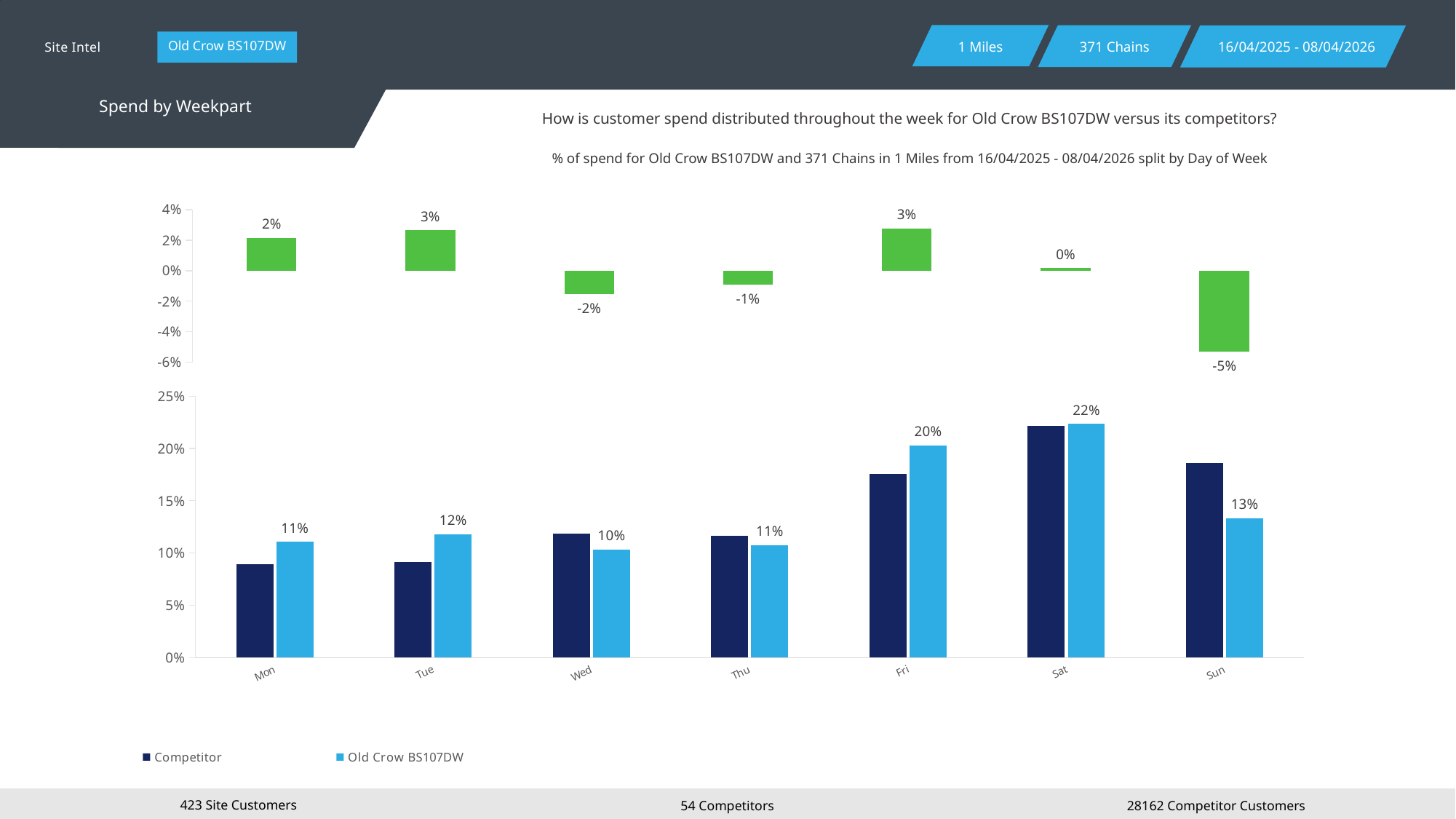
In the top chart, which day has the lowest value? Sun In the bottom chart, what is the value for Old Crow BS107DW on Wed? 10% How many series does the legend of the bottom chart list? 2 In the bottom chart, on Sun, which is larger: the Competitor bar or the Old Crow BS107DW bar? Competitor In the bottom chart, on which day is the Old Crow BS107DW value highest? Sat In the bottom chart, is the Competitor value for Sun greater or less than 15%? greater In the top chart, what is the value shown for Mon? 2% In the bottom chart, what is the difference between the Old Crow BS107DW values for Sat and Sun? 9% In the bottom chart, what is the value for Old Crow BS107DW on Fri? 20% How many days of the week are shown on the x axis of the bottom chart? 7 What kind of chart is the bottom chart? Bar chart In the top chart, what is the value shown for Sun? -5%